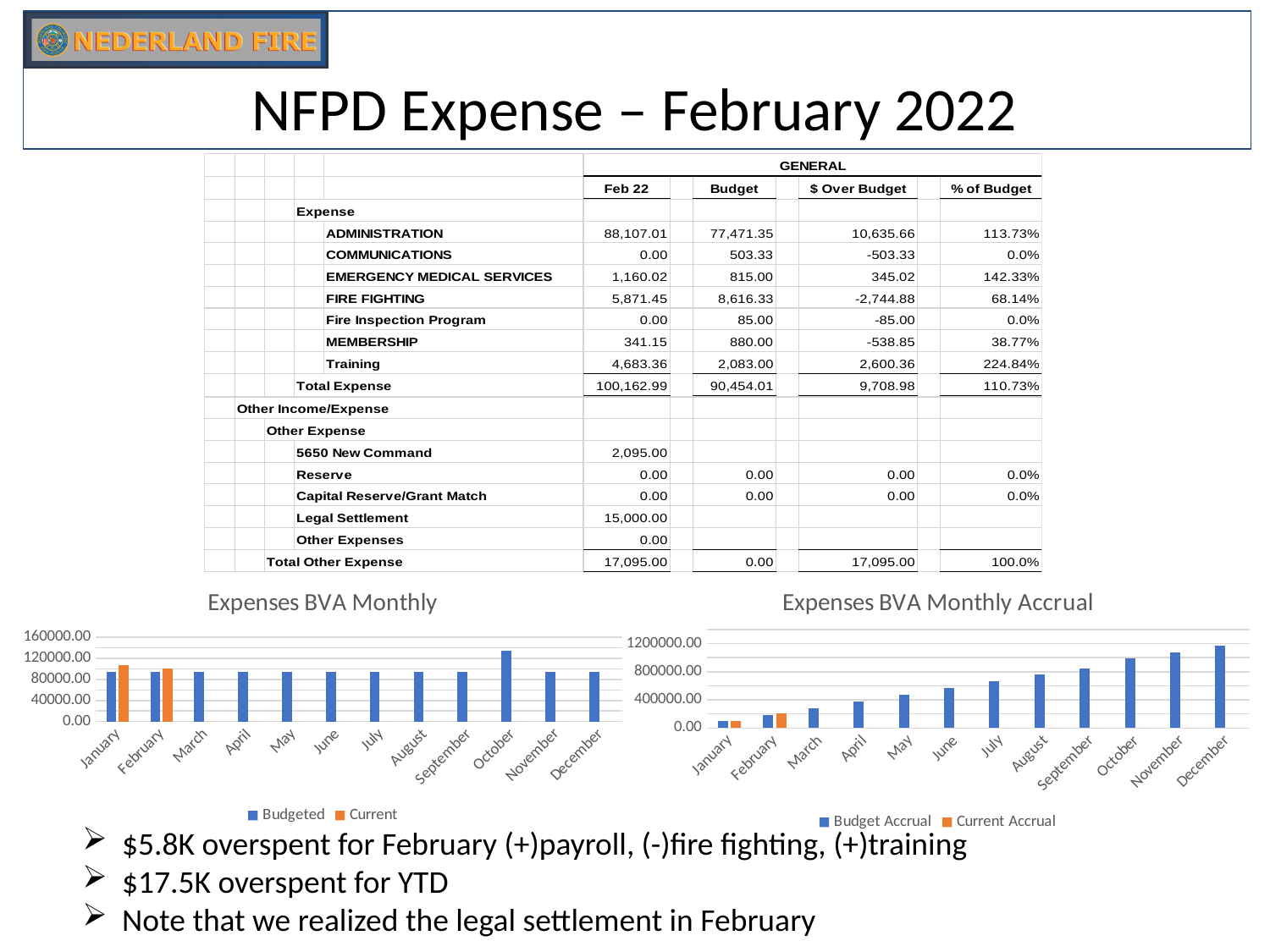
In the 'Expenses BVA Monthly Accrual' chart, how many months are shown on the x axis? 12 In the 'Expenses BVA Monthly Accrual' chart, is the Budget Accrual value for December greater or less than 800000? greater In the 'Expenses BVA Monthly' chart, how many series does the legend list? 2 In the 'Expenses BVA Monthly' chart, is the Budgeted value for March greater or less than 120000? less In the 'Expenses BVA Monthly Accrual' chart, which month has the lowest Budget Accrual value? January In the 'Expenses BVA Monthly Accrual' chart, what are the two legend entries? Budget Accrual and Current Accrual What kind of chart is the 'Expenses BVA Monthly Accrual' chart? bar chart In the 'Expenses BVA Monthly' chart, is the Budgeted value for October greater or less than 120000? greater In the 'Expenses BVA Monthly' chart, which month has the highest Budgeted value? October In the 'Expenses BVA Monthly Accrual' chart, do the Budget Accrual values rise or fall from January to December? rise In the 'Expenses BVA Monthly' chart, which is larger for January: the Budgeted value or the Current value? Current What kind of chart is the 'Expenses BVA Monthly' chart? bar chart